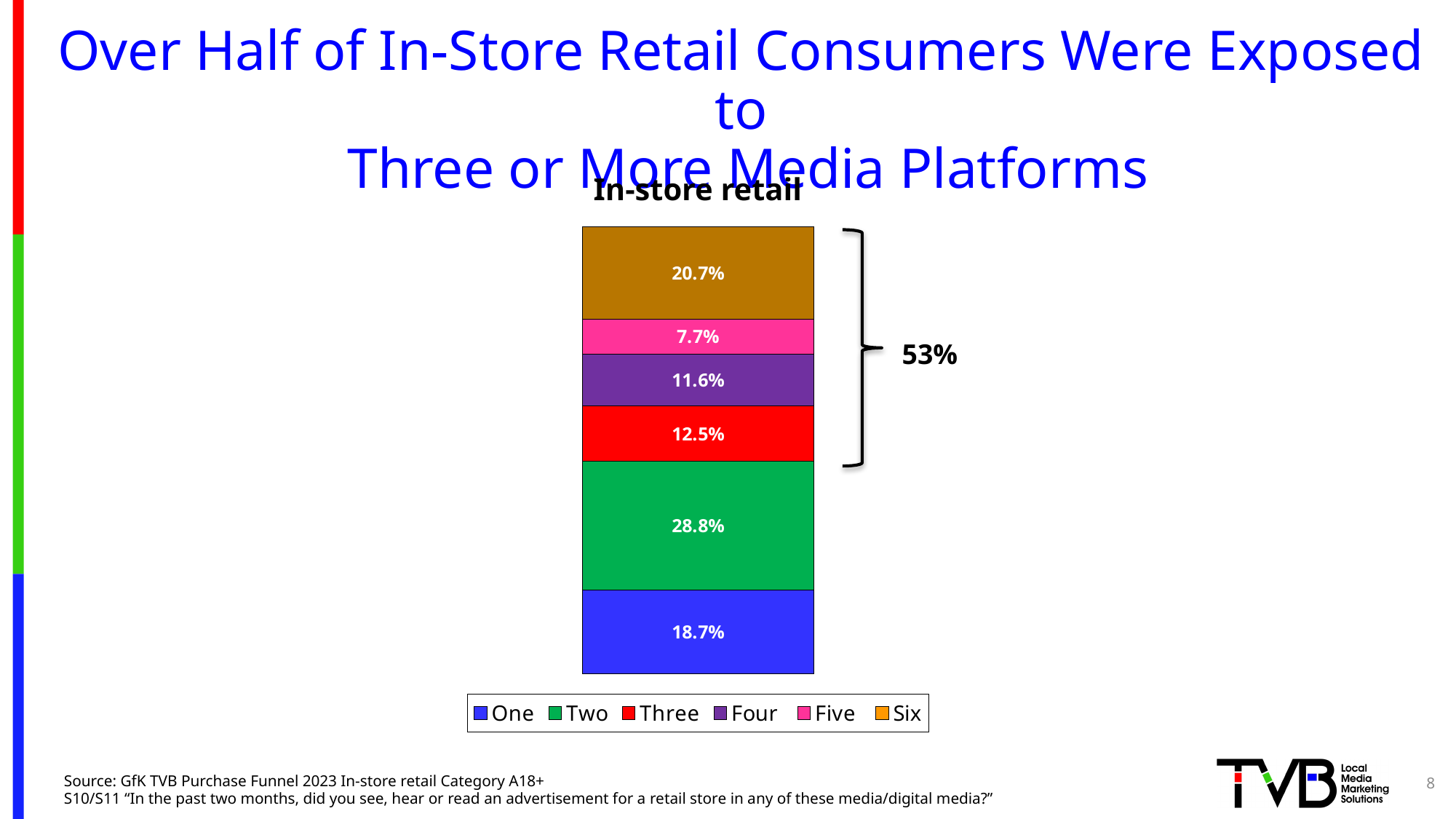
What is the title of the chart? In-store retail Which series has the smallest segment in the stacked bar? Five What is the value of the 'Five' segment? 7.7% What kind of chart is shown on the slide? Stacked bar chart What combined percentage is indicated by the bracket covering the 'Three' through 'Six' segments? 53% What is the difference between the 'Two' segment and the 'One' segment? 10.1% Which series has the largest segment in the stacked bar? Two What is the value of the 'One' segment? 18.7% How many series does the legend list? 6 What percentage of in-store retail consumers were exposed to two media platforms? 28.8% What is the value of the 'Six' segment in the stacked bar? 20.7% Which is larger, the 'Three' segment or the 'Four' segment? Three